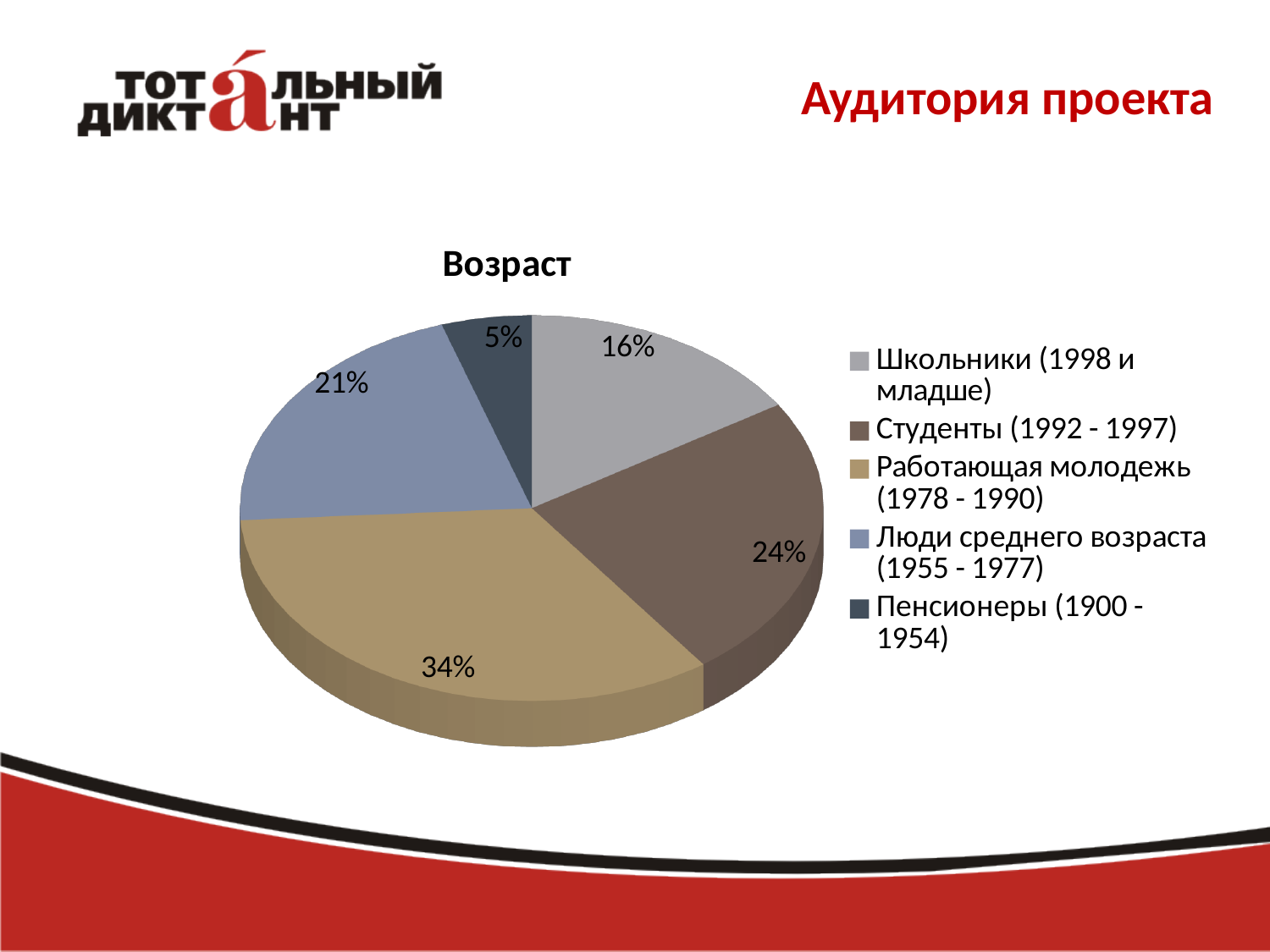
Which category has the smallest slice? Пенсионеры (1900 - 1954) What is the difference between the shares of Работающая молодежь (1978 - 1990) and Студенты (1992 - 1997)? 10% What is the title of the chart? Возраст What share of the pie is Работающая молодежь (1978 - 1990)? 34% How many categories does the pie chart have? 5 Which is larger, the share of Студенты (1992 - 1997) or the share of Люди среднего возраста (1955 - 1977)? Студенты (1992 - 1997) Which category has the largest slice? Работающая молодежь (1978 - 1990) What share of the pie is Школьники (1998 и младше)? 16% What share of the pie is Пенсионеры (1900 - 1954)? 5% What kind of chart is shown on the slide? pie chart